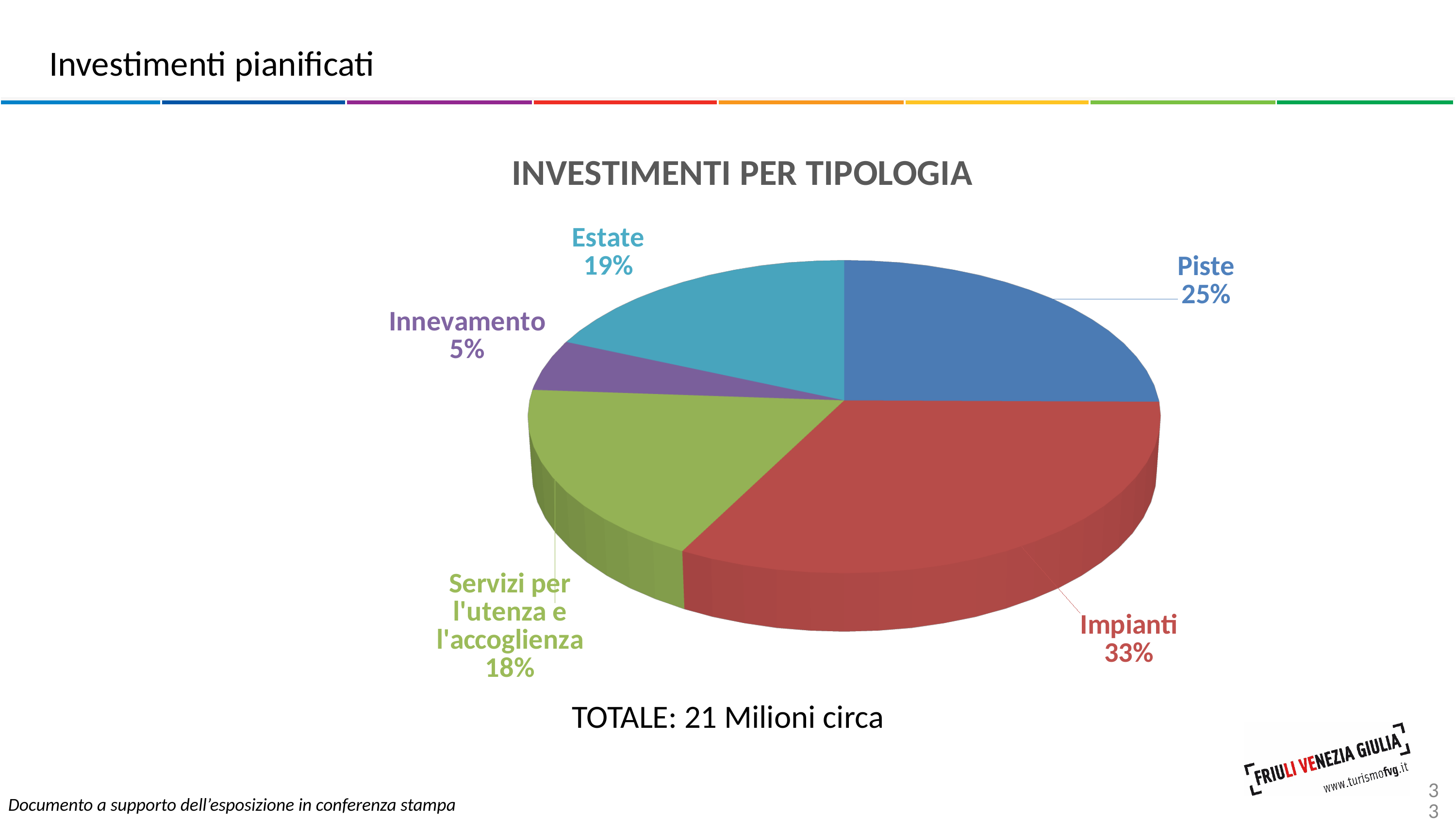
What share of the pie does Servizi per l'utenza e l'accoglienza represent? 18% Which category has the smallest slice of the pie? Innevamento What share of the pie does Innevamento represent? 5% What share of the pie does Estate represent? 19% Which is larger, the share for Piste or the share for Estate? Piste How many slices does the pie chart have? 5 What kind of chart is shown on the slide? Pie chart What is the difference in percentage points between Impianti and Piste? 8 Which category has the largest slice of the pie? Impianti What is the title of the chart? INVESTIMENTI PER TIPOLOGIA